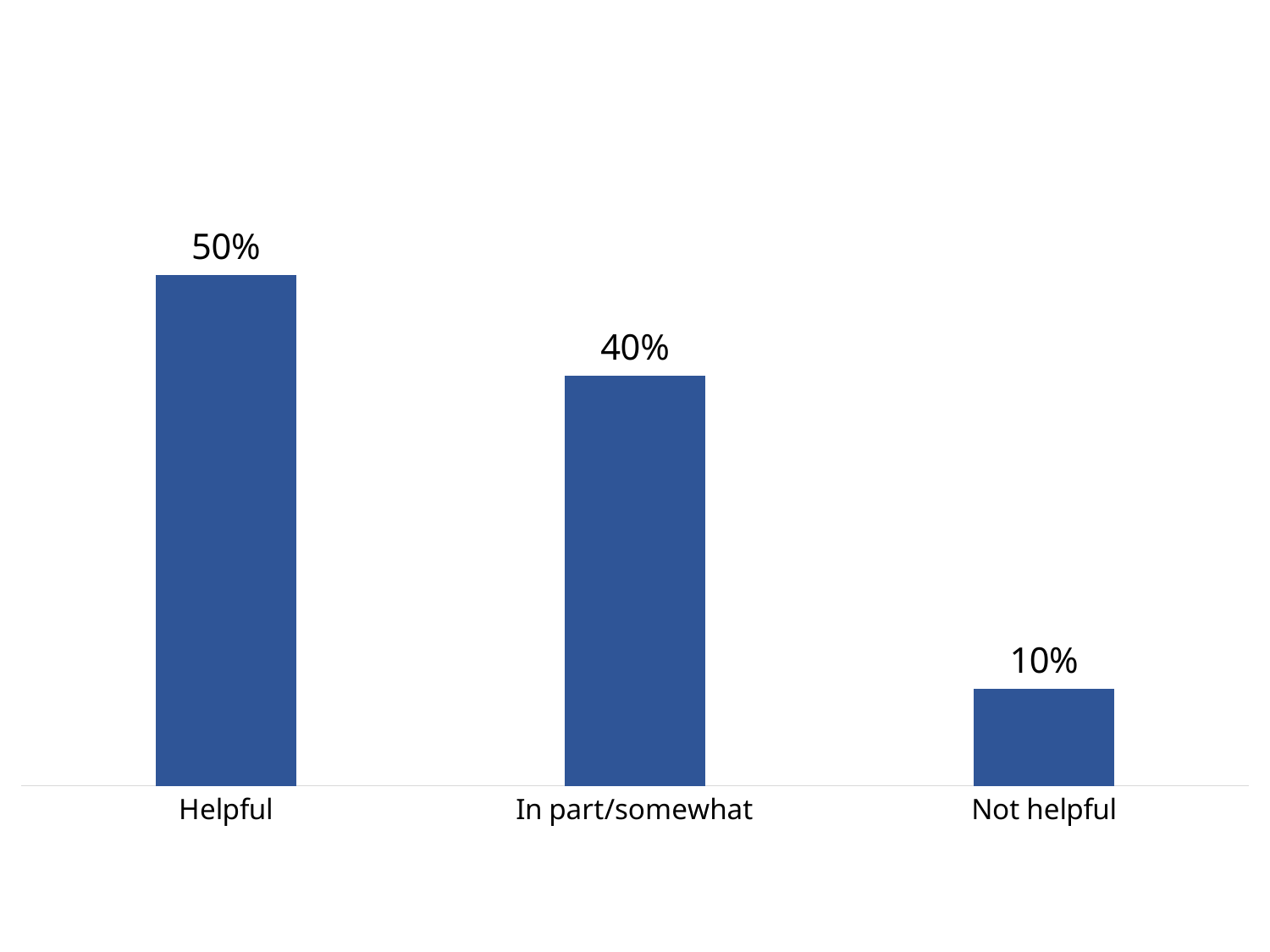
Which category has the lowest value? Not helpful What kind of chart is this? Bar chart What is the value for In part/somewhat? 40% How many categories are shown in the chart? 3 What is the difference between the values for Helpful and In part/somewhat? 10% Which category has the highest value? Helpful What is the value for Helpful? 50% What colour are the bars in the chart? Blue Do the values rise or fall from left to right along the x axis? Fall Which is larger, the value for Helpful or the value for Not helpful? Helpful What is the value for Not helpful? 10% What is the difference between the values for In part/somewhat and Not helpful? 30%